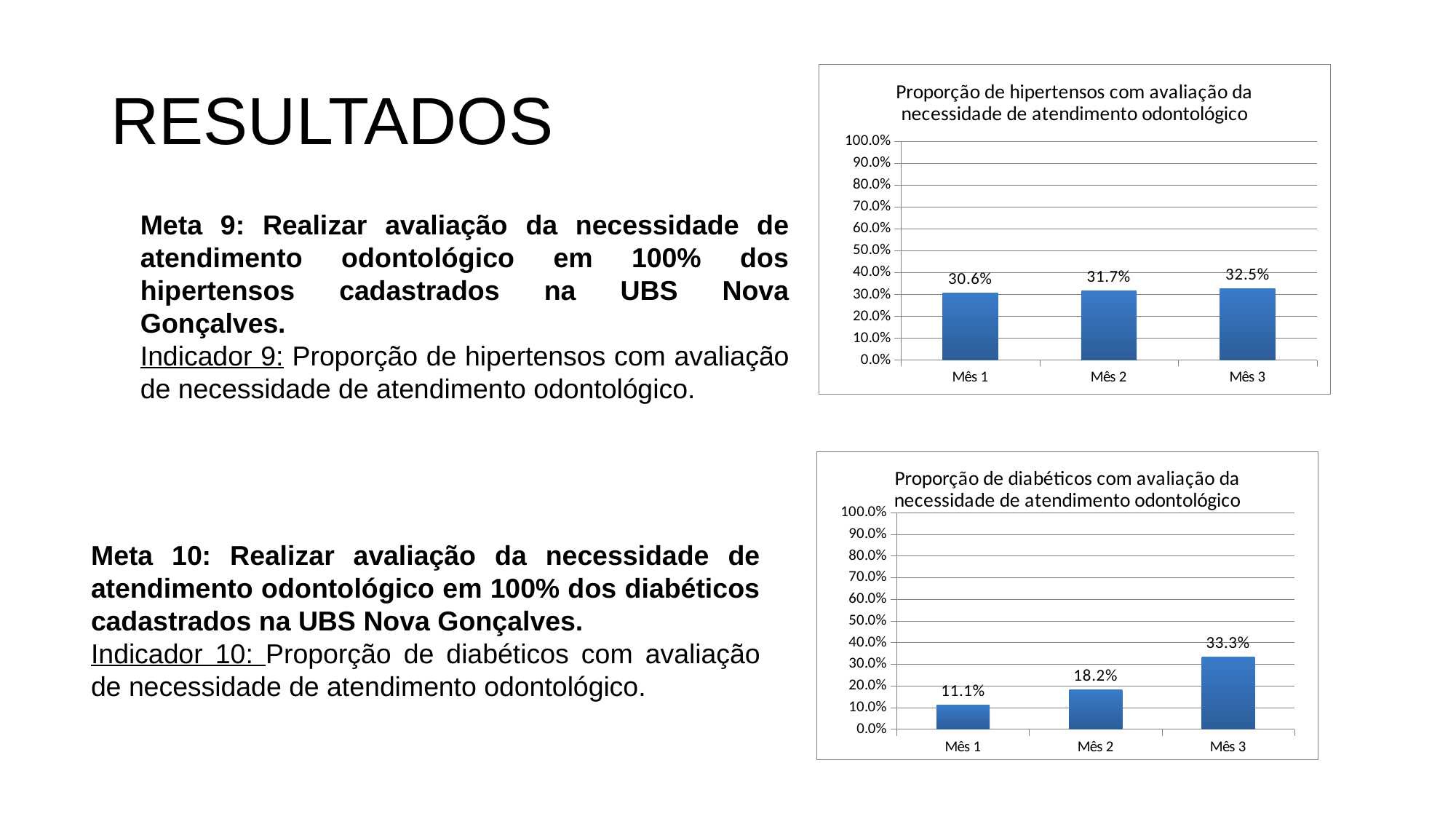
In the bottom chart (diabéticos), which month has the lowest value? Mês 1 In the bottom chart (diabéticos), which month has the highest value? Mês 3 In the top chart (hipertensos), what is the difference between the values for Mês 2 and Mês 1? 1.1% In the bottom chart (diabéticos), do the values rise or fall from Mês 1 to Mês 3? rise How many months (categories) are shown in the top chart (hipertensos)? 3 In the top chart (hipertensos), is the value for Mês 3 greater or less than 50.0%? less In the bottom chart (diabéticos), what is the difference between the values for Mês 3 and Mês 1? 22.2% What kind of chart is the bottom chart (diabéticos)? bar chart In the bottom chart (diabéticos), which is larger, the value for Mês 2 or Mês 3? Mês 3 In the bottom chart (Proporção de diabéticos com avaliação da necessidade de atendimento odontológico), what is the value for Mês 2? 18.2% In the top chart (Proporção de hipertensos com avaliação da necessidade de atendimento odontológico), what is the value for Mês 1? 30.6% In the top chart (hipertensos), what is the value for Mês 3? 32.5%